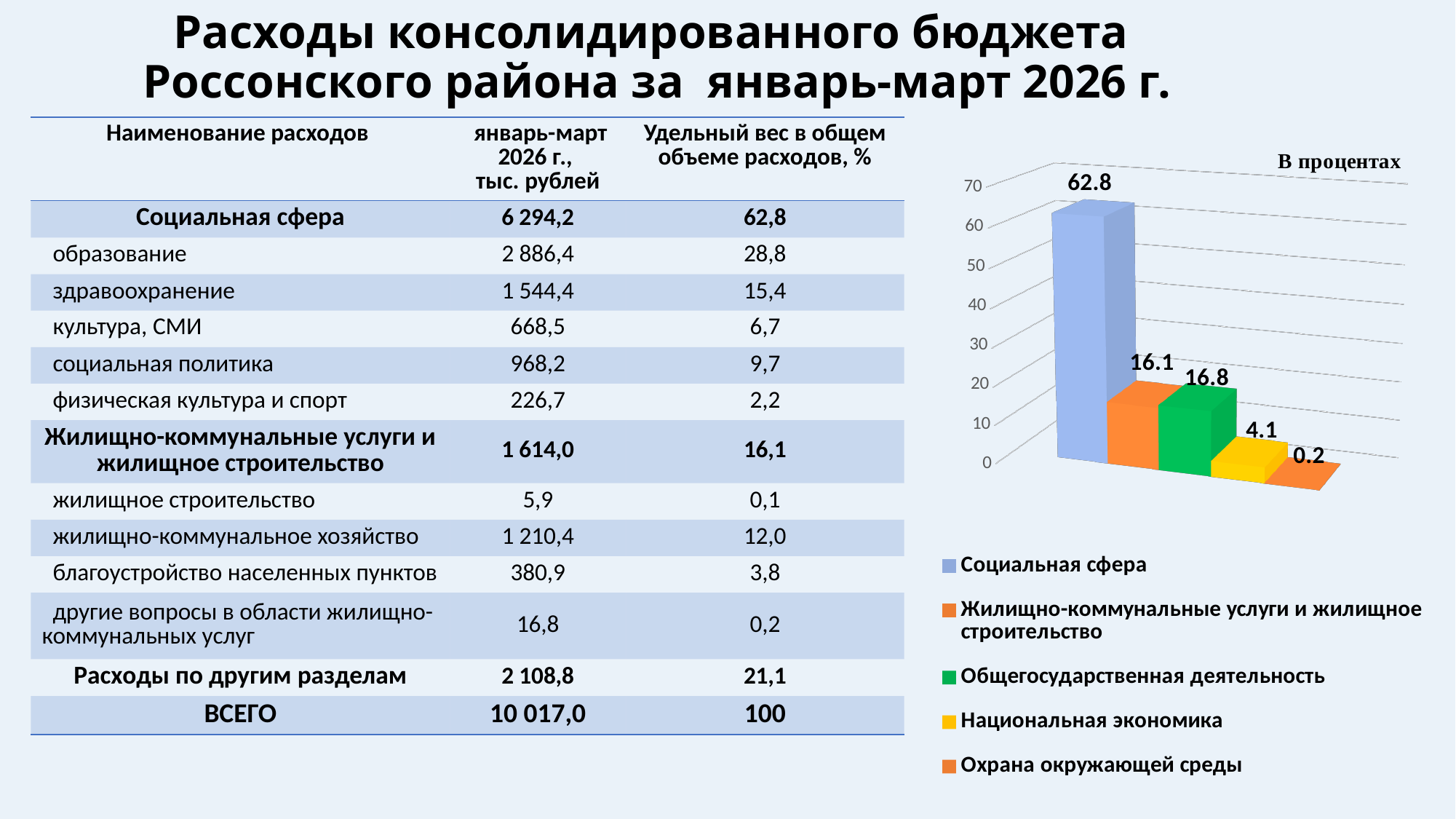
What is the value for Общегосударственная деятельность in the chart? 16.8 Which category has the lowest value in the chart? Охрана окружающей среды What is the difference between the values for Социальная сфера and Общегосударственная деятельность in the chart? 46.0 What is the value for Охрана окружающей среды in the chart? 0.2 Which is larger in the chart: Жилищно-коммунальные услуги и жилищное строительство or Общегосударственная деятельность? Общегосударственная деятельность Which category has the highest value in the chart? Социальная сфера What is the value for Национальная экономика in the chart? 4.1 What kind of chart is shown on the slide? bar chart How many bars are plotted in the chart? 5 Is the value for Социальная сфера in the chart greater or less than 60? greater How many entries does the chart legend list? 5 What is the value for Социальная сфера in the chart? 62.8